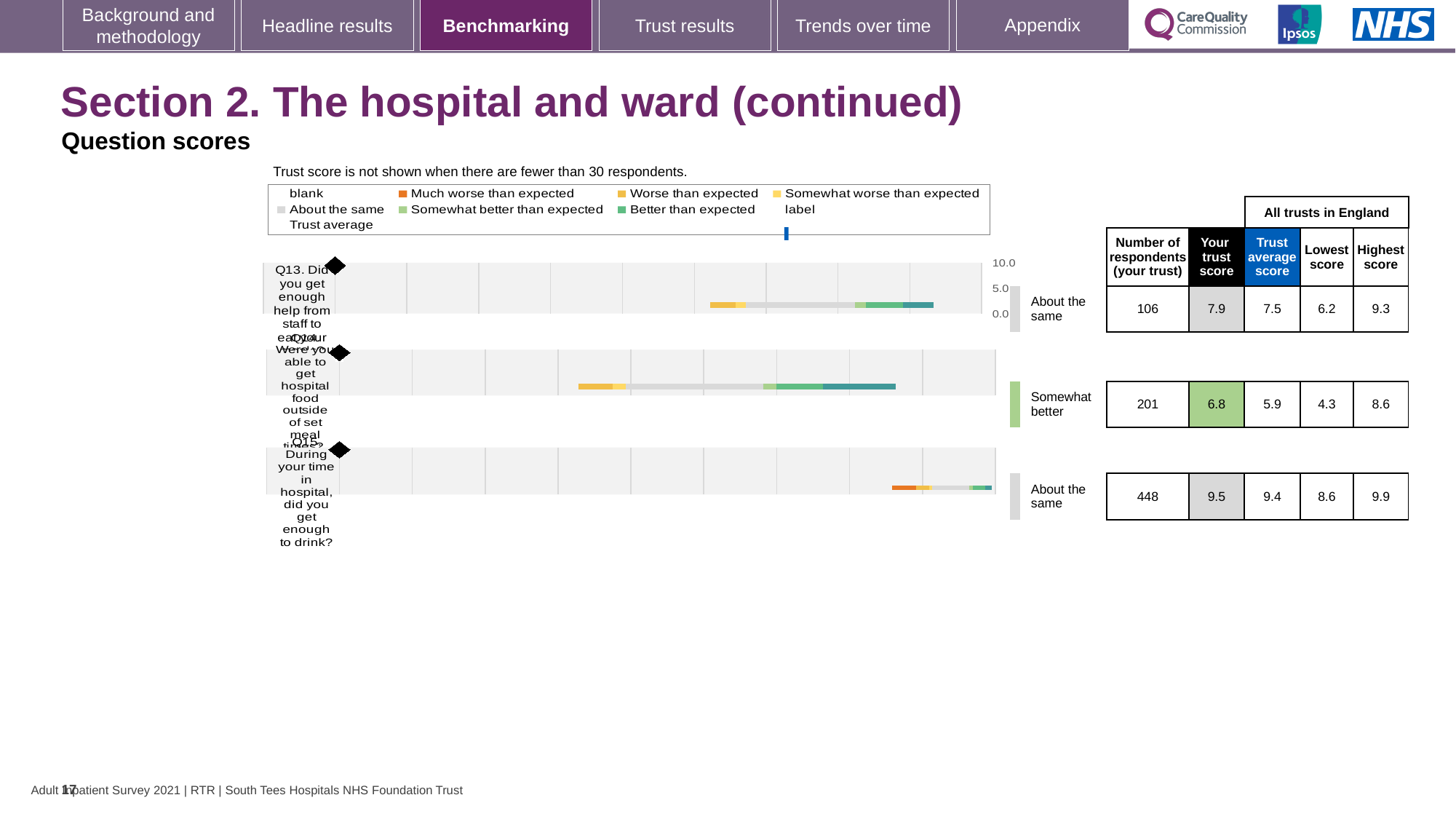
What is the highest score across all trusts in England for Q13? 9.3 What kind of chart is used to show the question scores on this slide? Bar chart How many questions are plotted in the chart on this slide? 3 What is the 'Your trust score' value for Q13 (Did you get enough help from staff to eat your meals?)? 7.9 What is the trust average score for Q15 (During your time in hospital, did you get enough to drink?)? 9.4 Which question has the highest 'Your trust score' on this slide? Q15 For Q13, which is larger: the 'Your trust score' or the trust average score? Your trust score Which question has the lowest 'Your trust score' on this slide? Q14 How many respondents from your trust answered Q14 (Were you able to get hospital food outside of set meal times?)? 201 What benchmark category is shown for Q14 (Were you able to get hospital food outside of set meal times?)? Somewhat better What is the difference between the 'Your trust score' for Q15 and for Q14? 2.7 What is the difference between the highest score and the lowest score across all trusts in England for Q14? 4.3